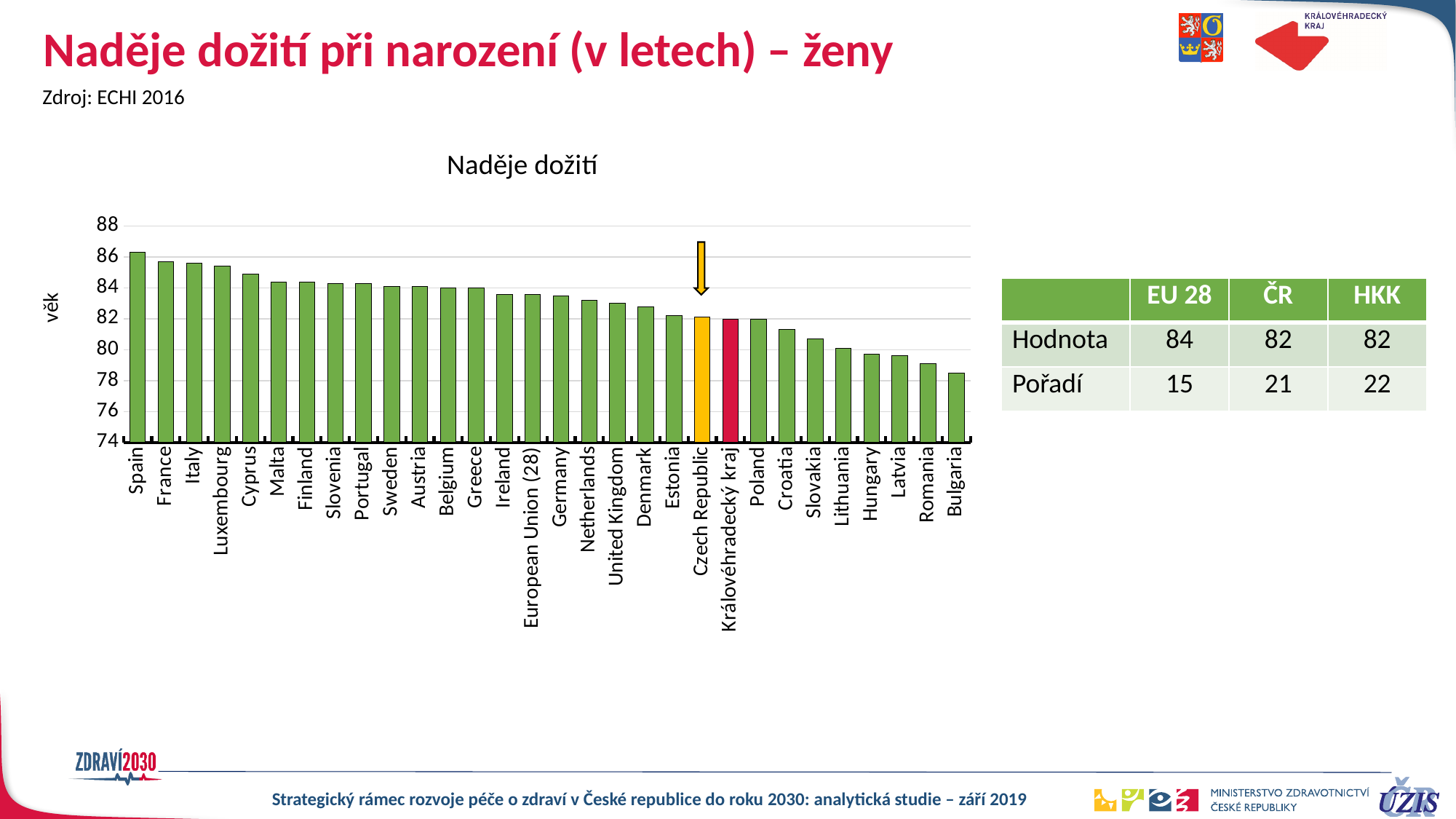
What colour is the bar for Královéhradecký kraj? red Which has the larger value, France or Romania? France Which country has the highest life expectancy in the chart? Spain How many categories (bars) are plotted in the chart? 30 What kind of chart is shown on the slide? bar chart Which country has the lowest life expectancy in the chart? Bulgaria Do the values rise or fall moving from left to right along the x axis? fall Is the value for Poland greater or less than 80? greater Is the value for Germany greater or less than 82? greater What is the title of the chart? Naděje dožití Is the value for Spain greater or less than 84? greater